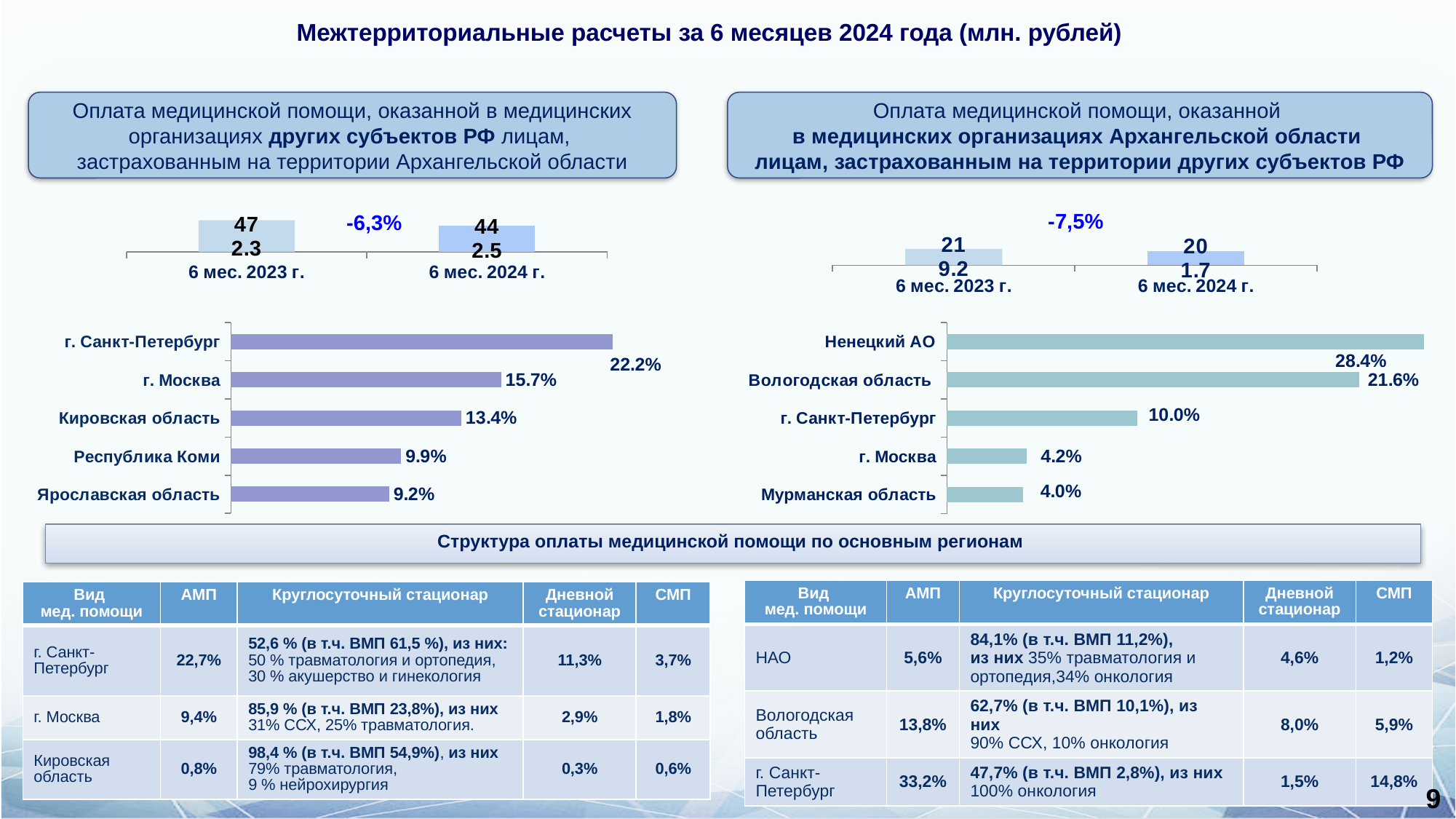
In the left-hand region bar chart (below the left blue box), what is the value for г. Санкт-Петербург? 22.2% In the small bar chart at the top left, what is the value for 6 мес. 2024 г.? 442.5 In the right-hand region bar chart, what is the value for Вологодская область? 21.6% In the right-hand region bar chart, what is the difference between the values for Ненецкий АО and Вологодская область? 6.8% In the left-hand region bar chart, which region has the lowest value? Ярославская область In the right-hand region bar chart, which is larger: the value for г. Санкт-Петербург or г. Москва? г. Санкт-Петербург In the right-hand region bar chart (below the right blue box), which region has the highest value? Ненецкий АО In the small bar chart at the top left, what percentage change is shown between 6 мес. 2023 г. and 6 мес. 2024 г.? -6,3% What type of chart is used to show the regions below the blue boxes? Bar chart In the small bar chart at the top right, what is the value for 6 мес. 2023 г.? 219.2 In the left-hand region bar chart, how many regions are shown? 5 In the left-hand region bar chart, what is the difference between the values for г. Москва and Кировская область? 2.3%